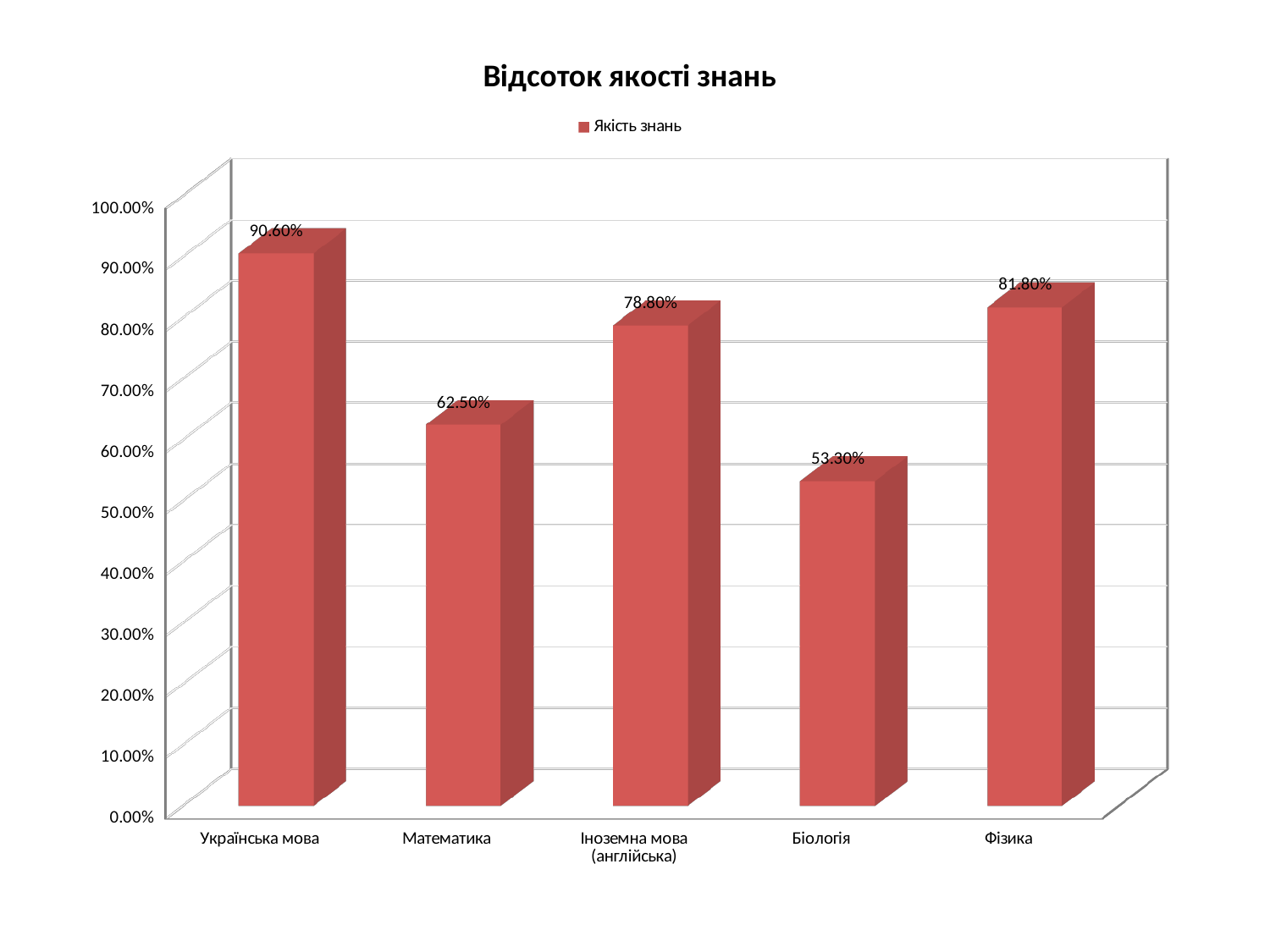
What is the value for Українська мова? 90.60% What is the difference between the values for Українська мова and Біологія? 37.30% What kind of chart is this? Bar chart What is the title of the chart? Відсоток якості знань Which is larger, the value for Фізика or the value for Іноземна мова (англійська)? Фізика What is the value for Іноземна мова (англійська)? 78.80% Which subject has the highest value? Українська мова Which subject has the lowest value? Біологія What is the value for Біологія? 53.30% What is the value for Математика? 62.50% How many subjects are shown on the chart? 5 What is the value for Фізика? 81.80%